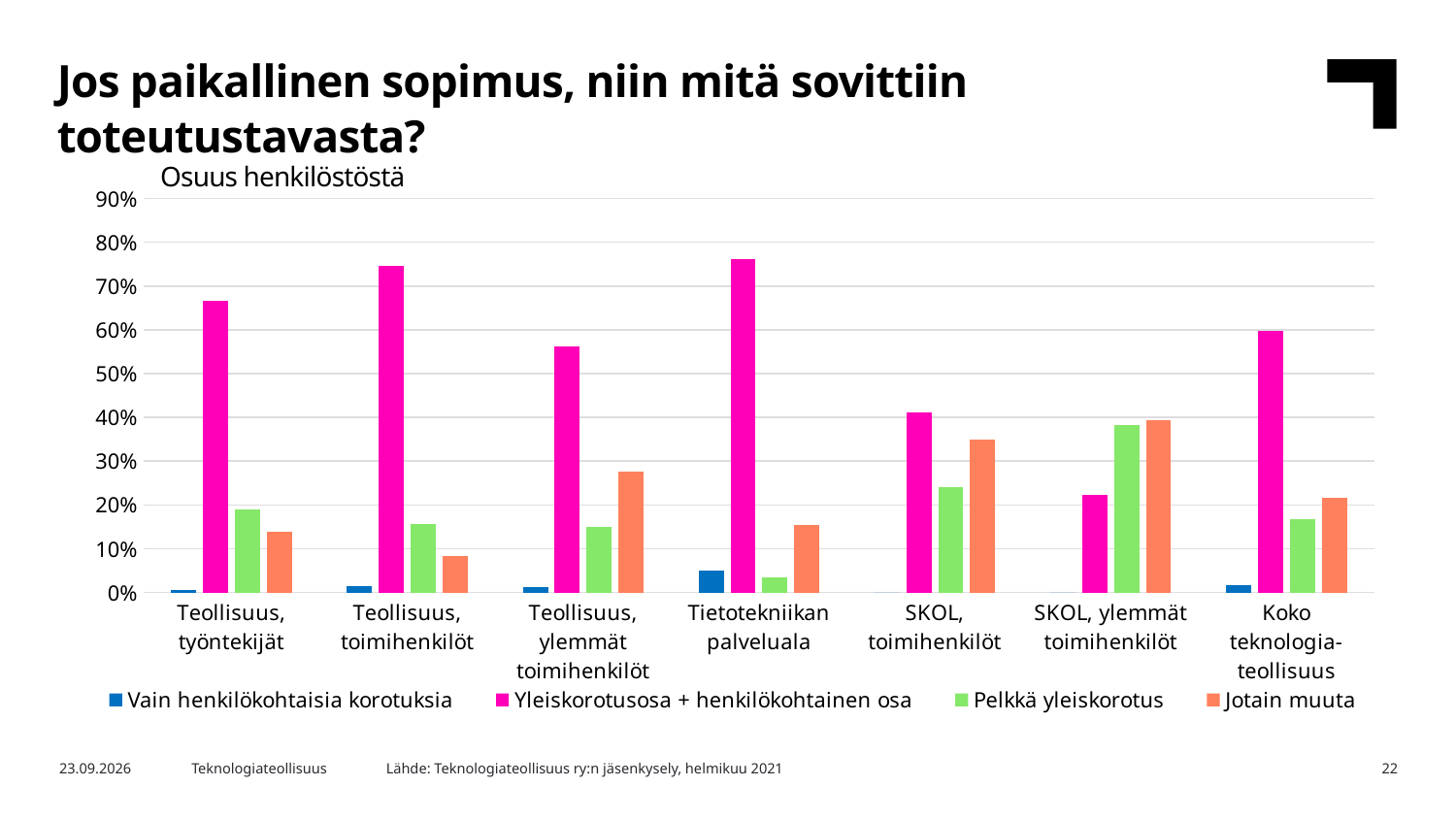
Which is larger: the 'Yleiskorotusosa + henkilökohtainen osa' value for 'Koko teknologiateollisuus' or for 'SKOL, toimihenkilöt'? Koko teknologiateollisuus Is the value of 'Jotain muuta' for 'Teollisuus, ylemmät toimihenkilöt' greater or less than 20%? greater Which category has the lowest value for the series 'Pelkkä yleiskorotus'? Tietotekniikan palveluala Which category has the lowest value for the series 'Jotain muuta'? Teollisuus, toimihenkilöt Which category has the highest value for the series 'Pelkkä yleiskorotus'? SKOL, ylemmät toimihenkilöt Which category has the highest value for the series 'Vain henkilökohtaisia korotuksia'? Tietotekniikan palveluala How many series does the legend list? 4 What is the label of the vertical axis of the chart? Osuus henkilöstöstä What kind of chart is shown on the slide? bar chart Is the value of 'Yleiskorotusosa + henkilökohtainen osa' for 'Teollisuus, työntekijät' greater or less than 60%? greater Which category has the lowest value for the series 'Yleiskorotusosa + henkilökohtainen osa'? SKOL, ylemmät toimihenkilöt How many categories are shown on the x axis of the chart? 7